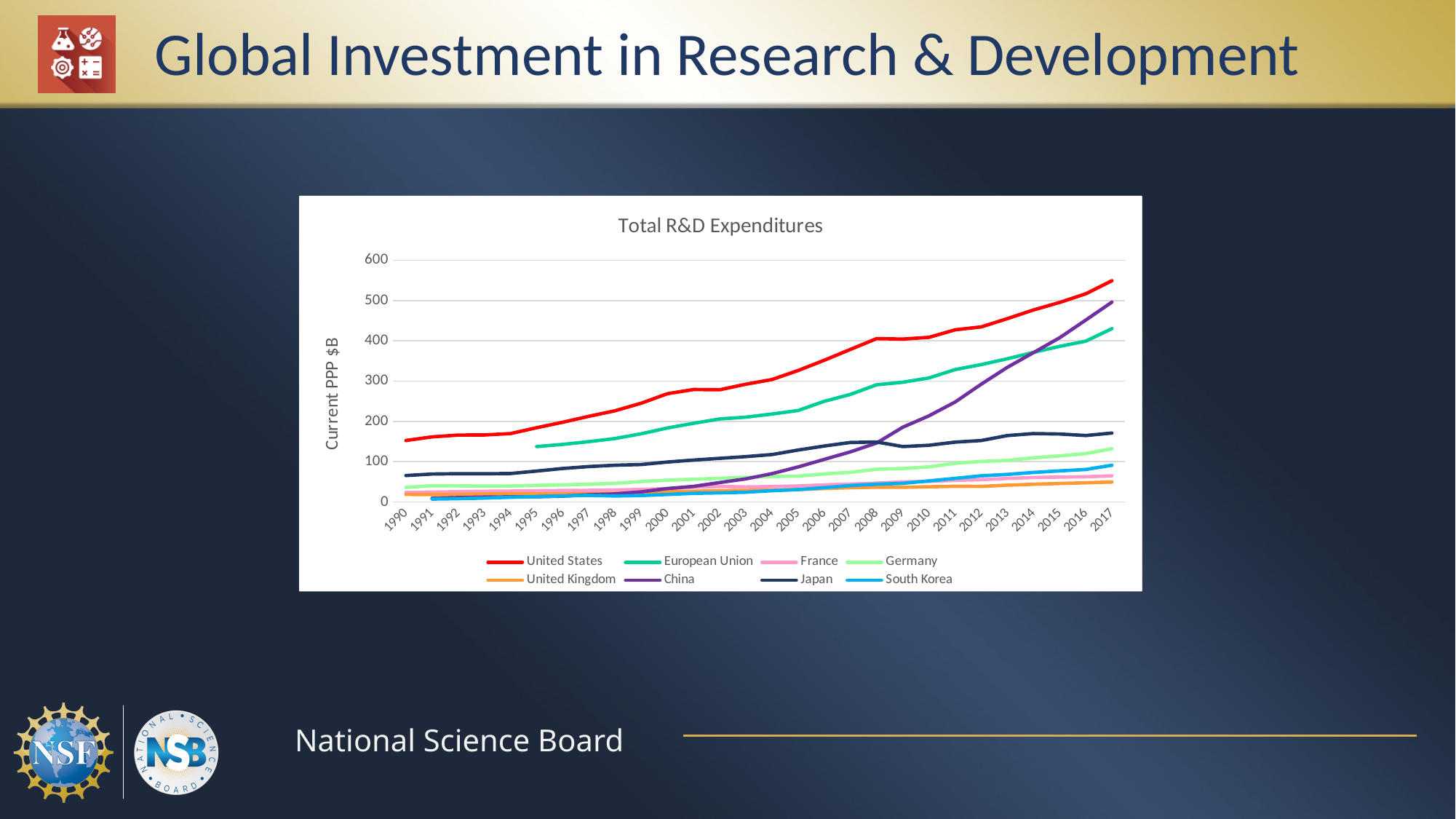
In 2017, which is larger, the value for China or the value for Japan? China What is the title of the chart? Total R&D Expenditures Is the value for Japan in 2017 greater or less than 200? less Which series has the highest value in 2017? United States Which series has the lowest value in 2017? United Kingdom Is the value for the European Union in 2017 greater or less than 400? greater What is the label on the y axis of the chart? Current PPP $B Is the value for the United States in 2017 greater or less than 500? greater How many series does the legend of the Total R&D Expenditures chart list? 8 What kind of chart is shown on the slide? line chart Does the value for China rise or fall from 2000 to 2017? rise How many years are shown along the x axis of the chart? 28